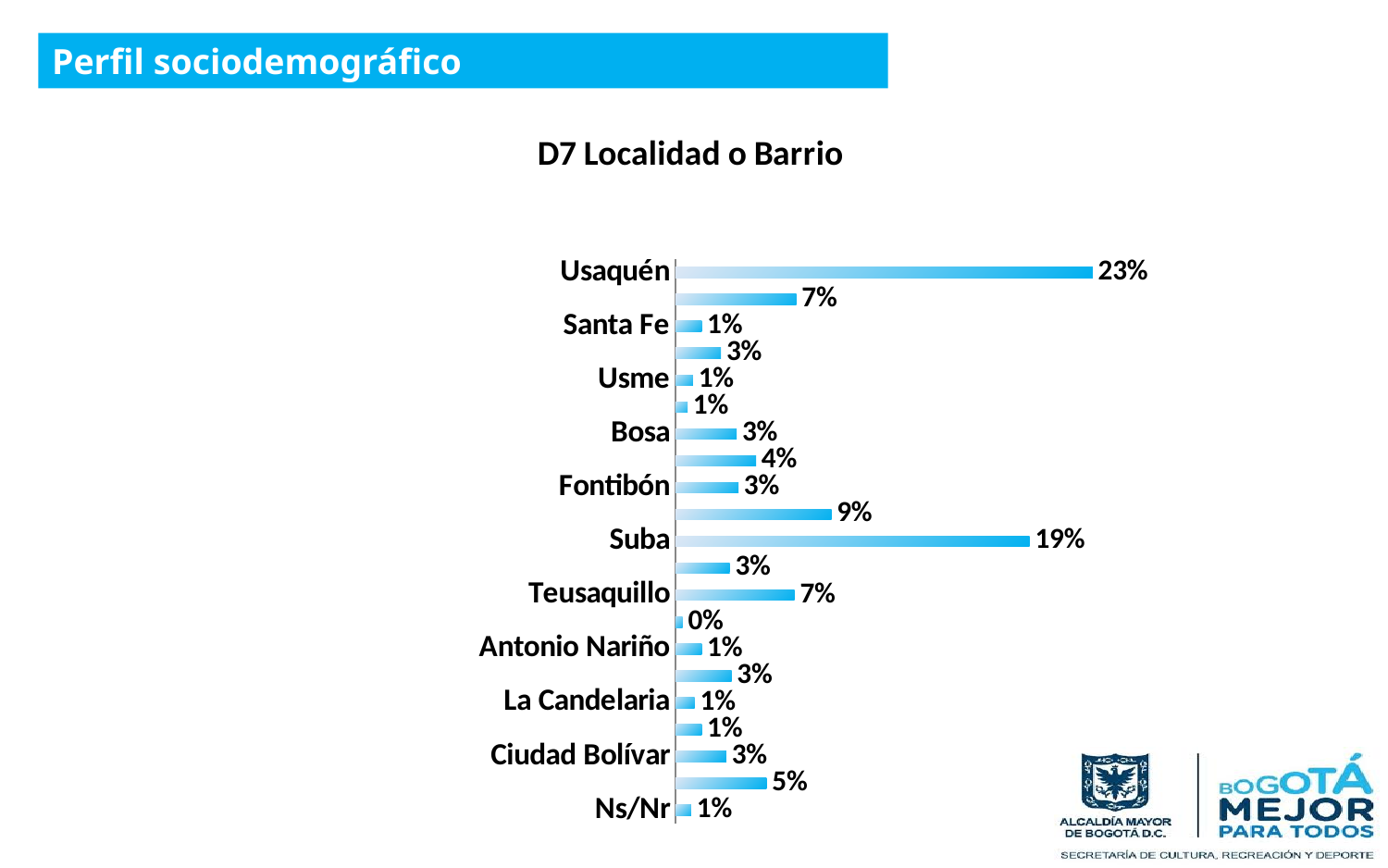
Which is larger, the value for Suba or the value for Teusaquillo? Suba Which is larger, the value for Usaquén or the value for Santa Fe? Usaquén Which category has the highest value? Usaquén What is the value for Usaquén? 23% What is the title of the chart? D7 Localidad o Barrio What is the value for Suba? 19% What is the value for Teusaquillo? 7% What kind of chart is shown on the slide? Bar chart What is the difference between the values for Usaquén and Suba? 4 percentage points What is the value for Bosa? 3% What is the value for Fontibón? 3% What is the value for Ns/Nr? 1%